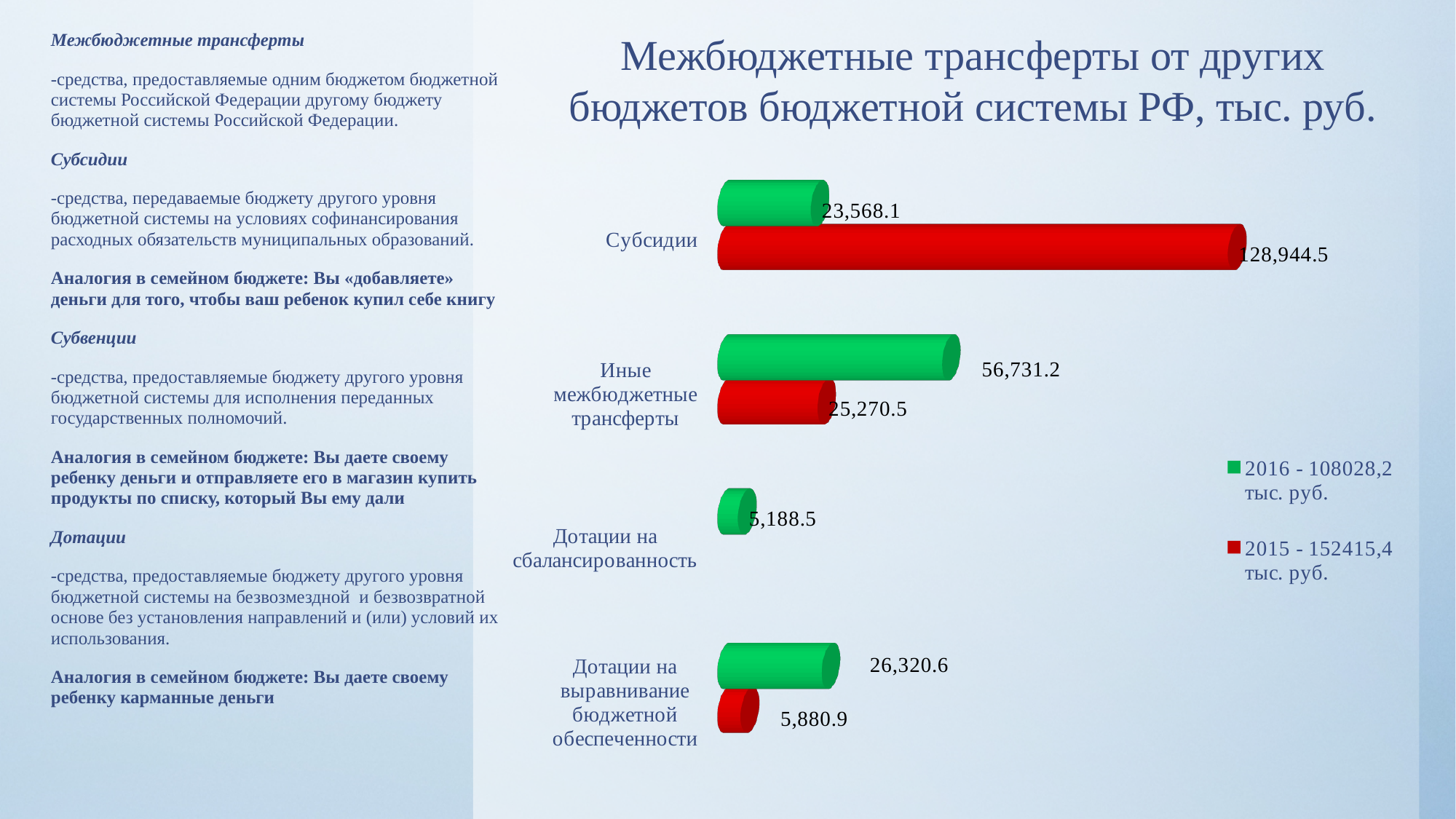
For Иные межбюджетные трансферты, which year has the larger value, 2015 or 2016? 2016 What is the 2015 value for Дотации на выравнивание бюджетной обеспеченности? 5,880.9 How many series does the legend list? 2 Which category has the highest 2015 value? Субсидии How many categories are shown on the chart? 4 What type of chart is shown on the slide? Bar chart What is the 2016 value for Дотации на сбалансированность? 5,188.5 What is the difference between the 2015 and 2016 values for Субсидии? 105,376.4 What is the 2015 value for Субсидии? 128,944.5 What is the 2016 value for Иные межбюджетные трансферты? 56,731.2 Which category has the lowest 2016 value? Дотации на сбалансированность What is the 2016 value for Субсидии? 23,568.1